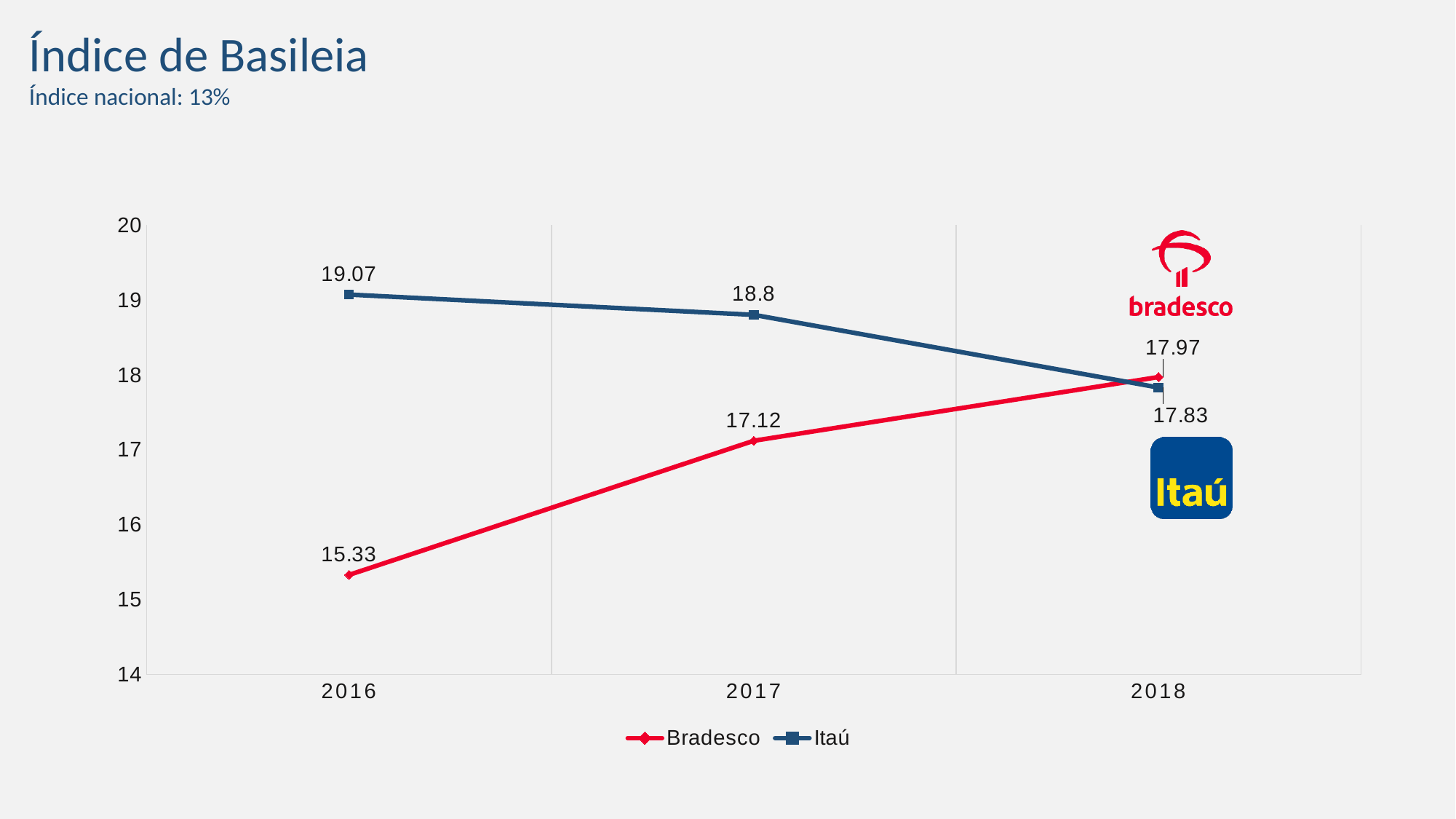
In which year is the Bradesco value highest? 2018 What is the value for Bradesco in 2018? 17.97 What is the value for Itaú in 2017? 18.8 What is the difference between the Itaú and Bradesco values in 2016? 3.74 How many series does the legend list? 2 How many years are shown on the x axis? 3 In which year is the Itaú value lowest? 2018 What kind of chart is shown on the slide? Line chart Which series has the larger value in 2017, Bradesco or Itaú? Itaú What is the value for Bradesco in 2016? 15.33 Does the Itaú series rise or fall from 2016 to 2018? Fall What is the value for Itaú in 2018? 17.83